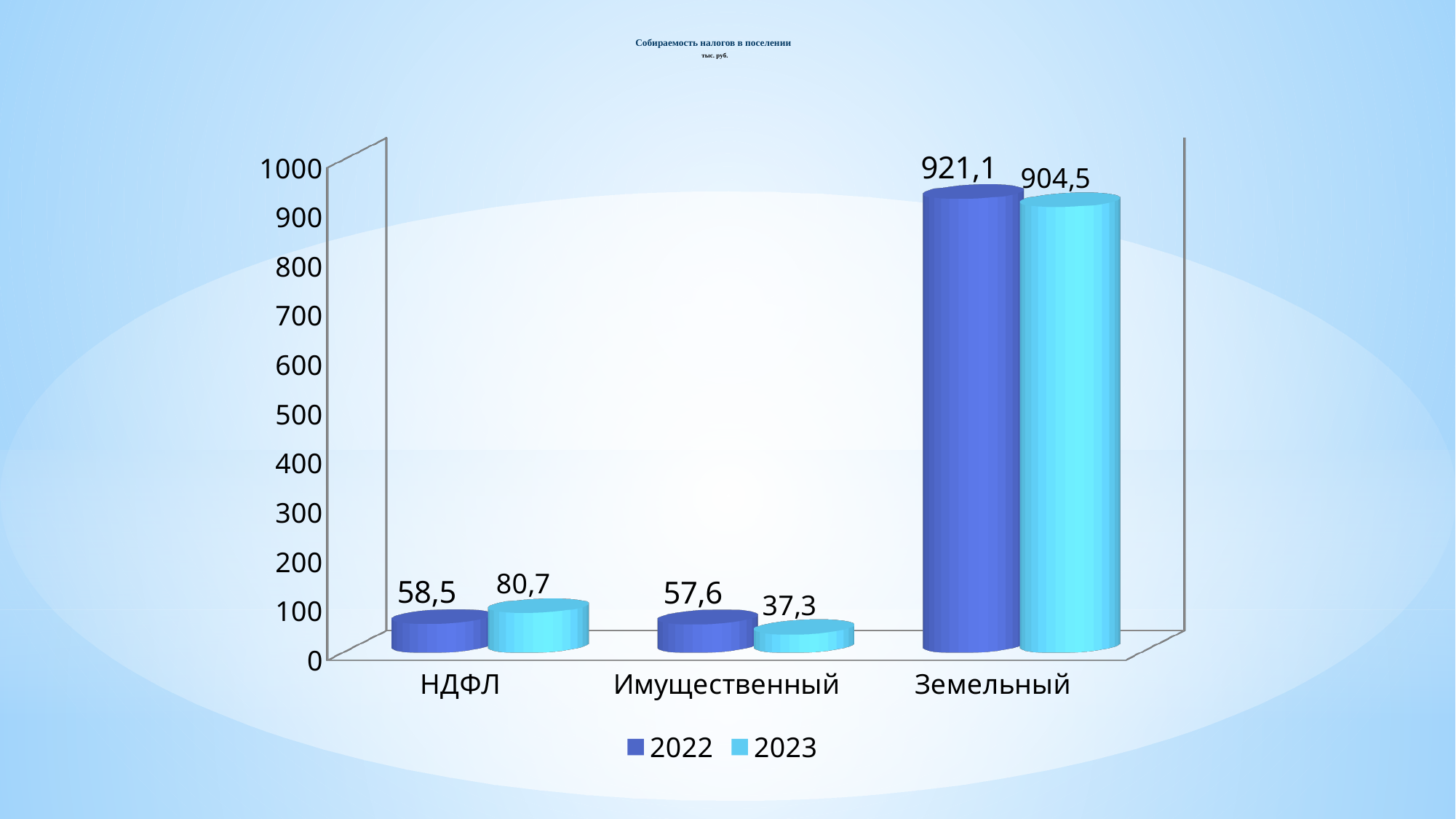
What unit is given under the chart title? тыс. руб. What is the value for НДФЛ in 2022? 58,5 Which category has the lowest value in 2023? Имущественный Is the value for Земельный in 2022 greater or less than 900? greater What is the difference between the 2022 and 2023 values for Земельный? 16,6 How many series does the legend list? 2 What kind of chart is shown on the slide? bar chart What is the value for Земельный in 2023? 904,5 Which category has the highest value in 2022? Земельный Which is larger for НДФЛ: the 2022 value or the 2023 value? 2023 How many categories are shown on the x axis? 3 What is the value for Имущественный in 2023? 37,3